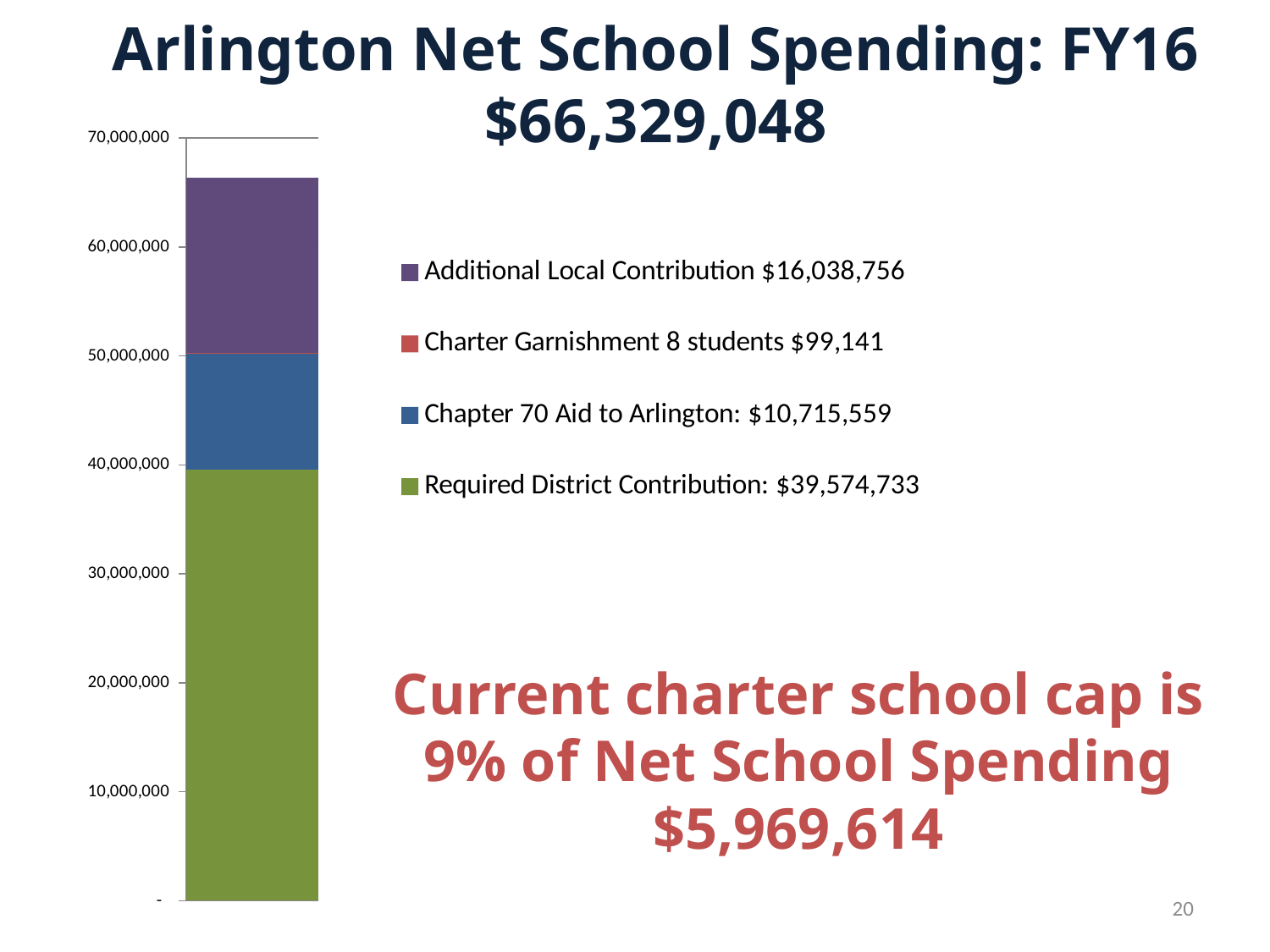
What kind of chart is shown on the slide? Stacked bar chart Which series has the largest value? Required District Contribution What is the value for Charter Garnishment (8 students)? $99,141 What is the value for Required District Contribution? $39,574,733 What is the difference between Additional Local Contribution and Chapter 70 Aid to Arlington? $5,323,197 Which is larger, Additional Local Contribution or Chapter 70 Aid to Arlington? Additional Local Contribution Which series has the smallest value? Charter Garnishment 8 students How many series does the legend list? 4 What is the value for Additional Local Contribution? $16,038,756 What is the value for Chapter 70 Aid to Arlington? $10,715,559 Is the top of the stacked bar greater or less than 60,000,000? greater What colour represents Required District Contribution in the chart? Green